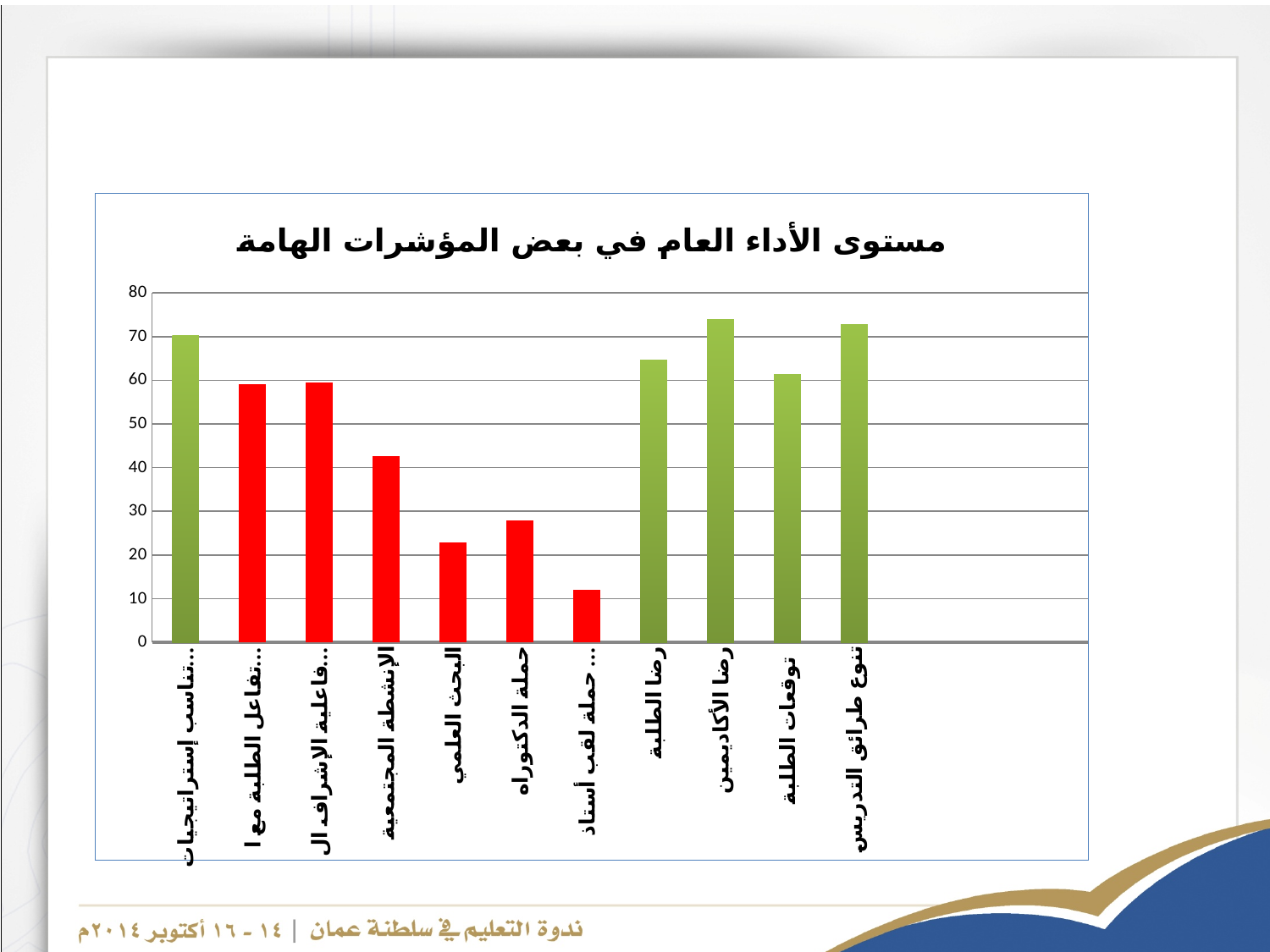
How many bars in the chart are coloured red? 6 What kind of chart is shown on the slide? bar chart How many bars are plotted in the chart? 11 Is the value for رضا الطلبة greater or less than 60? greater Is the value for رضا الأكاديميين greater or less than 70? greater Is the value for الأنشطة المجتمعية greater or less than 40? greater Which is larger, the value for رضا الطلبة or the value for البحث العلمي? رضا الطلبة Which is larger, the value for الأنشطة المجتمعية or the value for حملة الدكتوراه? الأنشطة المجتمعية Which category has the lowest bar in the chart? حملة لقب أستاذ What is the title of the chart? مستوى الأداء العام في بعض المؤشرات الهامة